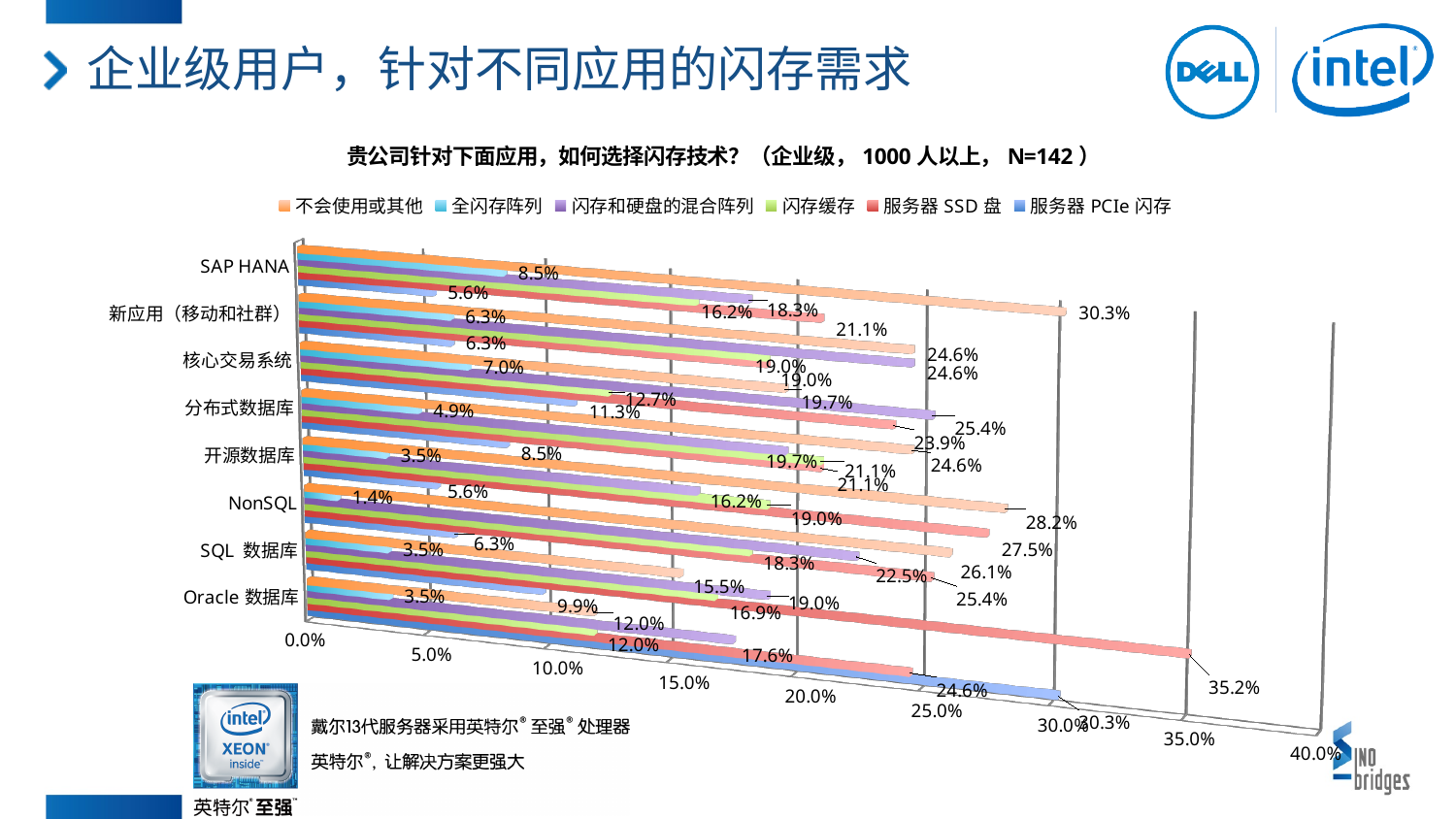
What is the highest tick value shown on the horizontal axis of the chart? 40.0% What is the largest value labelled on the chart? 35.2% Is the longest bar on the chart greater or less than 30%? greater What kind of chart is shown on the slide? bar chart How many series does the chart legend list? 6 What is the title of the chart? 贵公司针对下面应用，如何选择闪存技术？（企业级， 1000 人以上， N=142） Which category appears at the top of the vertical axis of the chart? SAP HANA What is the smallest value labelled on the chart? 1.4% How many application categories are listed on the vertical axis of the chart? 8 What is the value of the 不会使用或其他 bar for SAP HANA? 30.3%